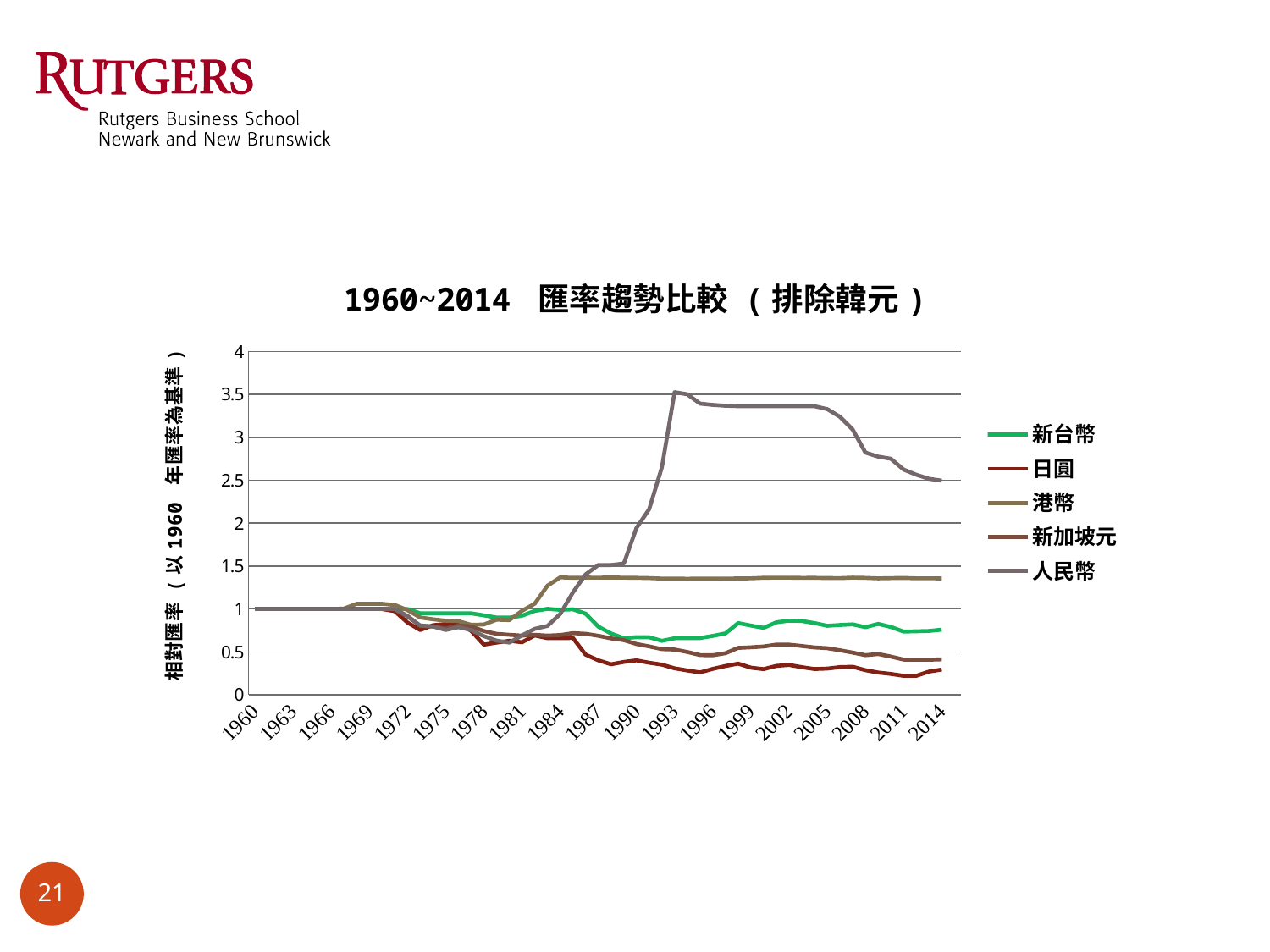
Which series is listed last in the legend? 人民幣 Is the value for 港幣 in 2014 greater or less than 1? greater Which series has the lowest value in 2014? 日圓 What is the title of the chart? 1960~2014 匯率趨勢比較（排除韓元） Is the value for 人民幣 in 2014 greater or less than 2? greater What is the value of 人民幣 in 1960? 1 In 2014, which is larger, the value for 港幣 or the value for 新加坡元? 港幣 Is the value for 日圓 in 2014 greater or less than 0.5? less What kind of chart is shown on the slide? line chart Does the 日圓 series rise or fall from 1960 to 2014? fall Which series has the highest value in 2014? 人民幣 How many series does the legend list? 5